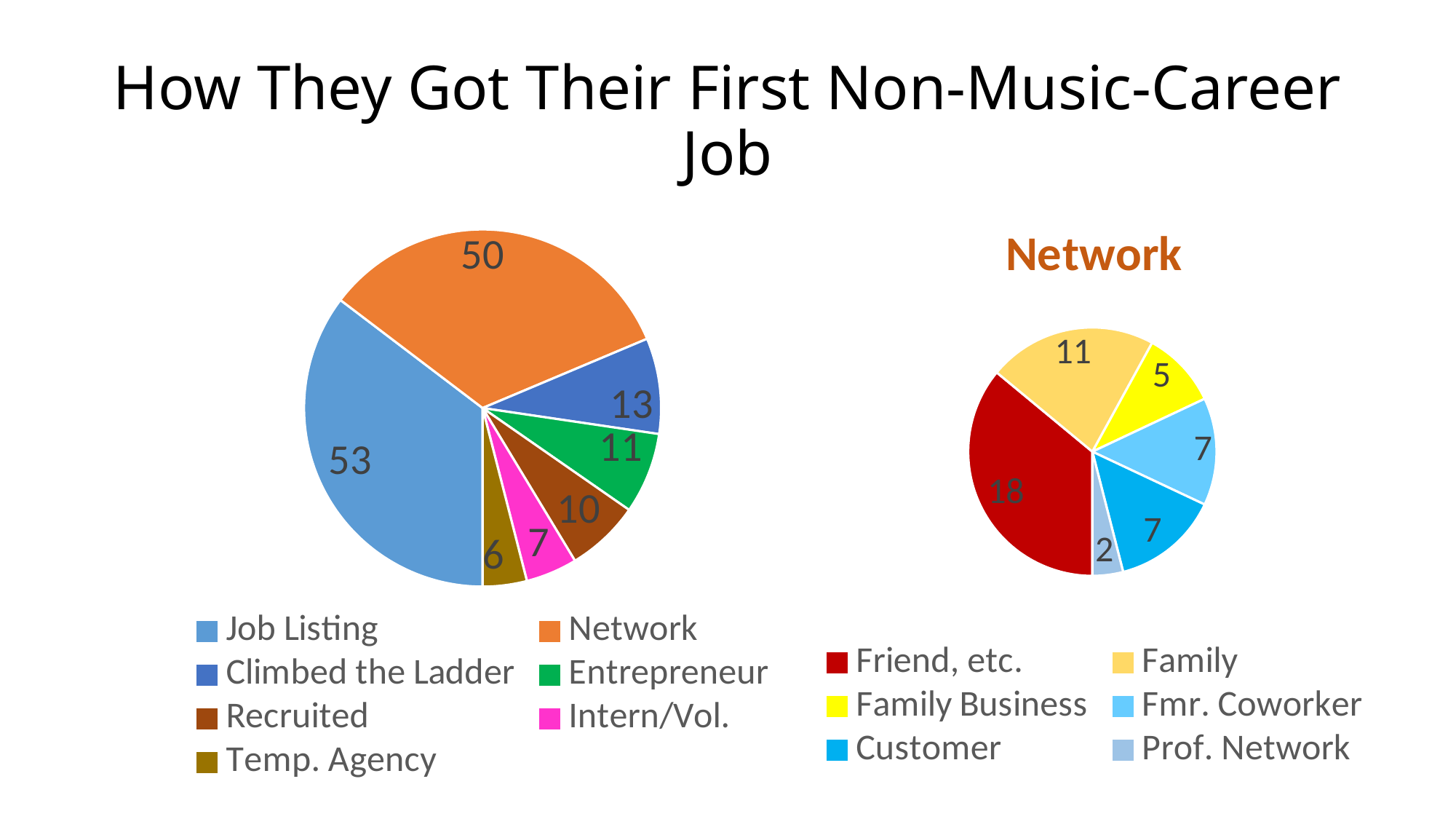
In the left pie chart, what is the value for Climbed the Ladder? 13 In the Network chart, what is the difference between Friend, etc. and Family? 7 In the left pie chart, what is the value for Job Listing? 53 What share of the Network chart does Family represent? 22% In the Network chart, what is the value for Prof. Network? 2 In the left pie chart, what is the difference between Job Listing and Network? 3 In the Network chart, which category has the largest value? Friend, etc. How many categories does the Network chart show? 6 In the left pie chart, which is larger, Entrepreneur or Recruited? Entrepreneur In the left pie chart, which category has the smallest value? Temp. Agency In the Network chart, what is the value for Friend, etc.? 18 What type of chart is the left chart? Pie chart